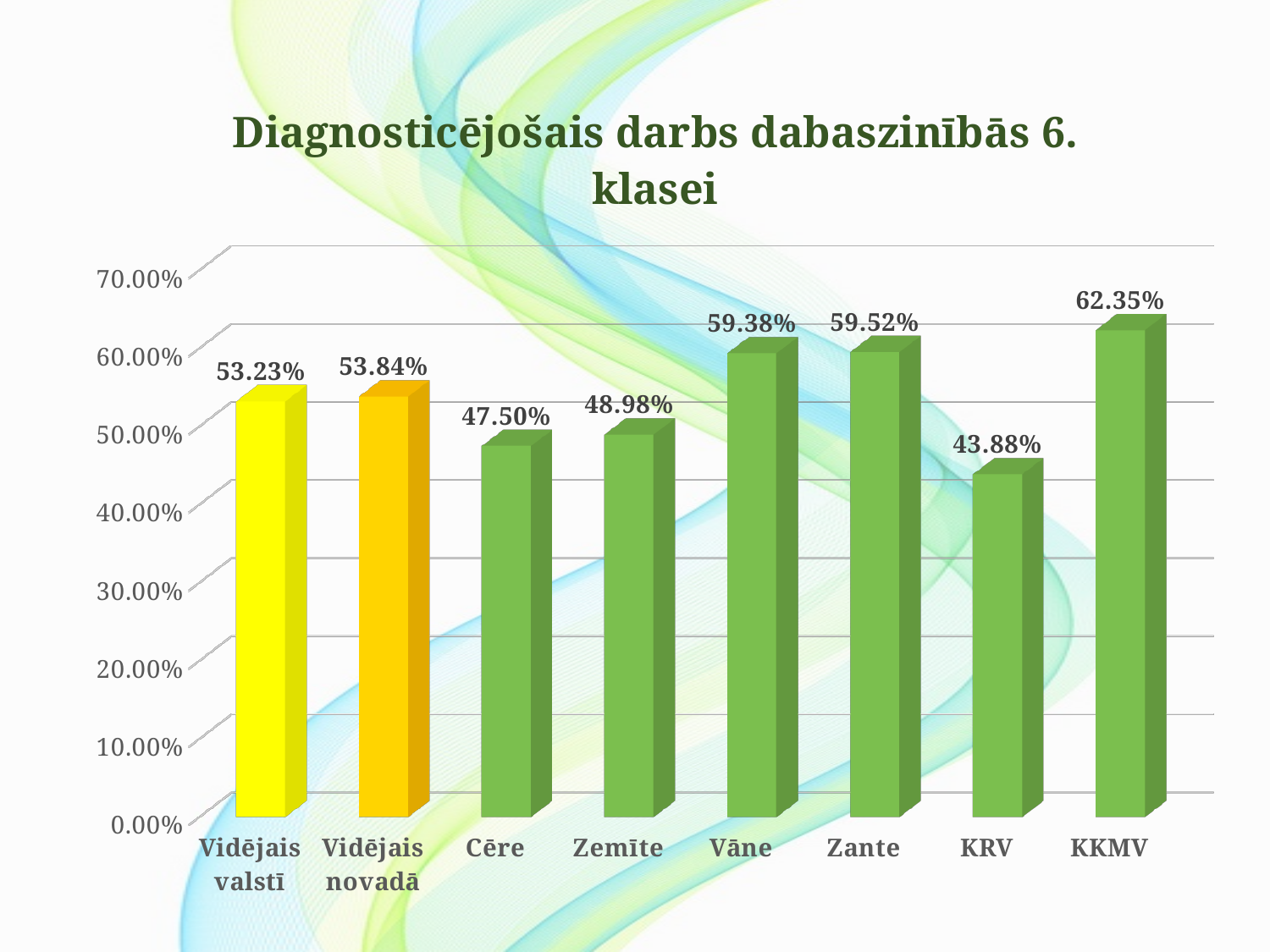
What is the difference between the values for Vidējais novadā and Vidējais valstī? 0.61% What is the title of the chart? Diagnosticējošais darbs dabaszinībās 6. klasei Which is larger, the value for Cēre or the value for Zemīte? Zemīte How many categories are shown on the x axis? 8 What kind of chart is shown on the slide? bar chart Which category has the lowest value? KRV Which category has the highest value? KKMV What is the value for KRV? 43.88% What is the difference between the values for KKMV and KRV? 18.47% What is the value for Vidējais valstī? 53.23% Is the value for Vāne greater or less than 50.00%? greater What is the value for KKMV? 62.35%